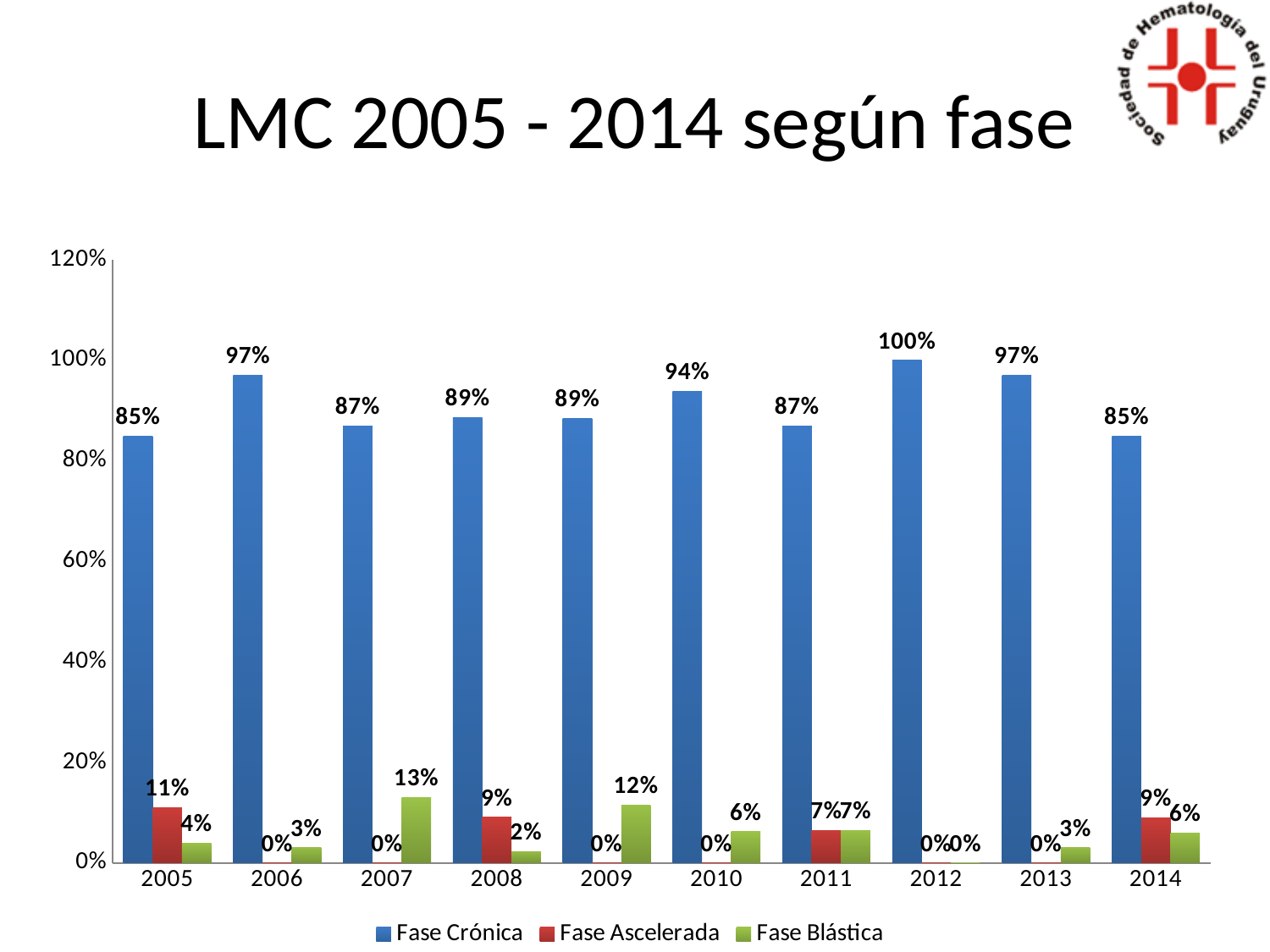
Which is larger, Fase Blástica in 2009 or Fase Blástica in 2010? Fase Blástica in 2009 What is the value for Fase Crónica in 2012? 100% What is the value for Fase Ascelerada in 2005? 11% What is the value for Fase Blástica in 2007? 13% Which year has the highest value for Fase Crónica? 2012 What is the difference between the Fase Crónica values for 2012 and 2014? 15% How many series does the legend list? 3 What kind of chart is shown on the slide? Bar chart How many years are shown on the x axis? 10 Is the value for Fase Crónica in 2010 greater or less than 80%? greater Which year has the highest value for Fase Blástica? 2007 What is the title of the chart? LMC 2005 - 2014 según fase